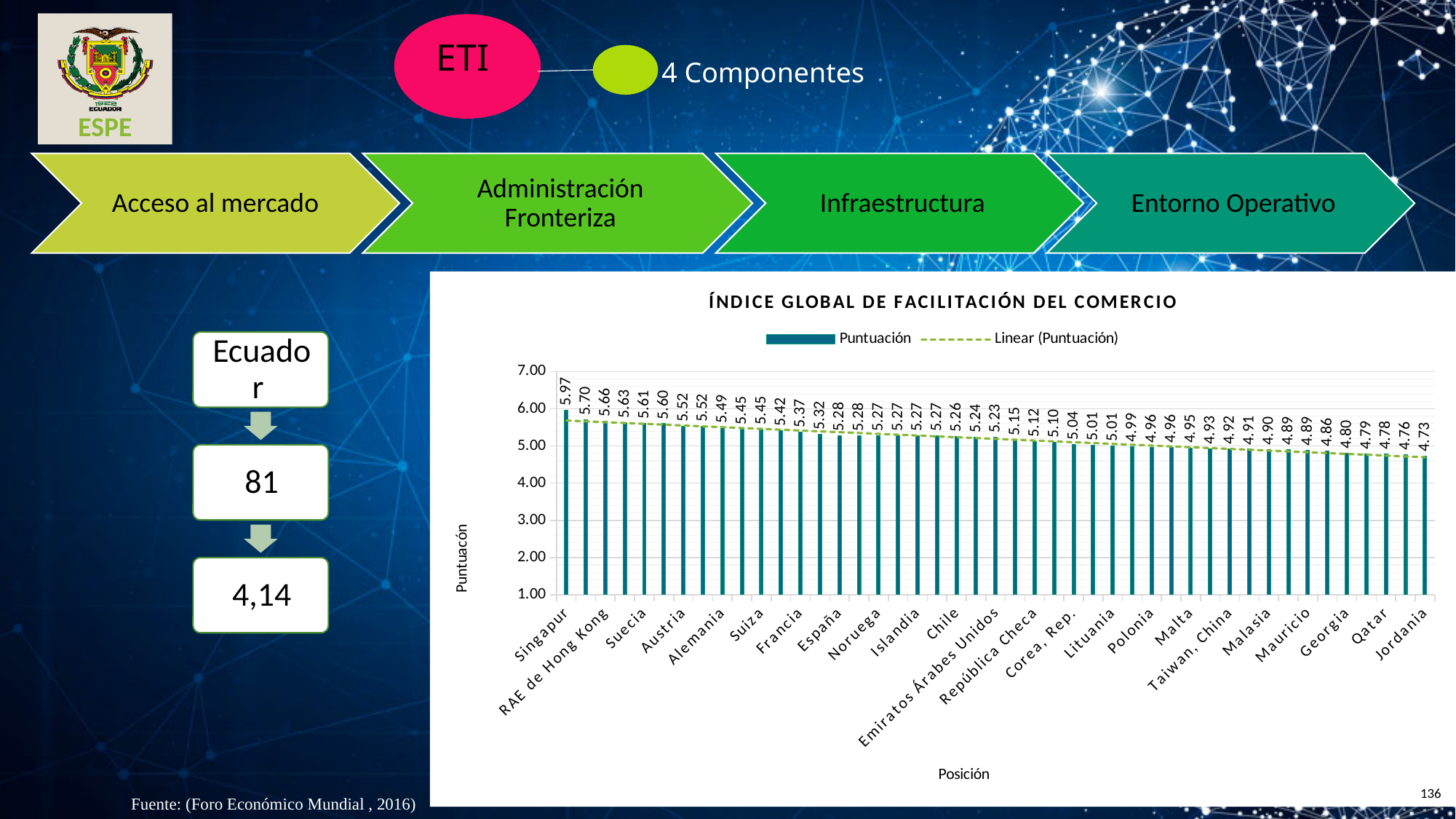
Which country has the highest Puntuación? Singapur What is the difference between the Puntuación of Singapur and Jordania? 1.24 Which has a higher Puntuación, Singapur or Jordania? Singapur Is the Puntuación for Chile greater or less than 5.00? greater How many entries does the legend list? 2 What type of chart is shown on the slide? bar chart Do the Puntuación values rise or fall from left to right along the x axis? fall Which country has the lowest Puntuación? Jordania Is the Puntuación for Georgia greater or less than 5.00? less What is the Puntuación value for Singapur? 5.97 What is the title of the chart? ÍNDICE GLOBAL DE FACILITACIÓN DEL COMERCIO What is the Puntuación value for Jordania? 4.73